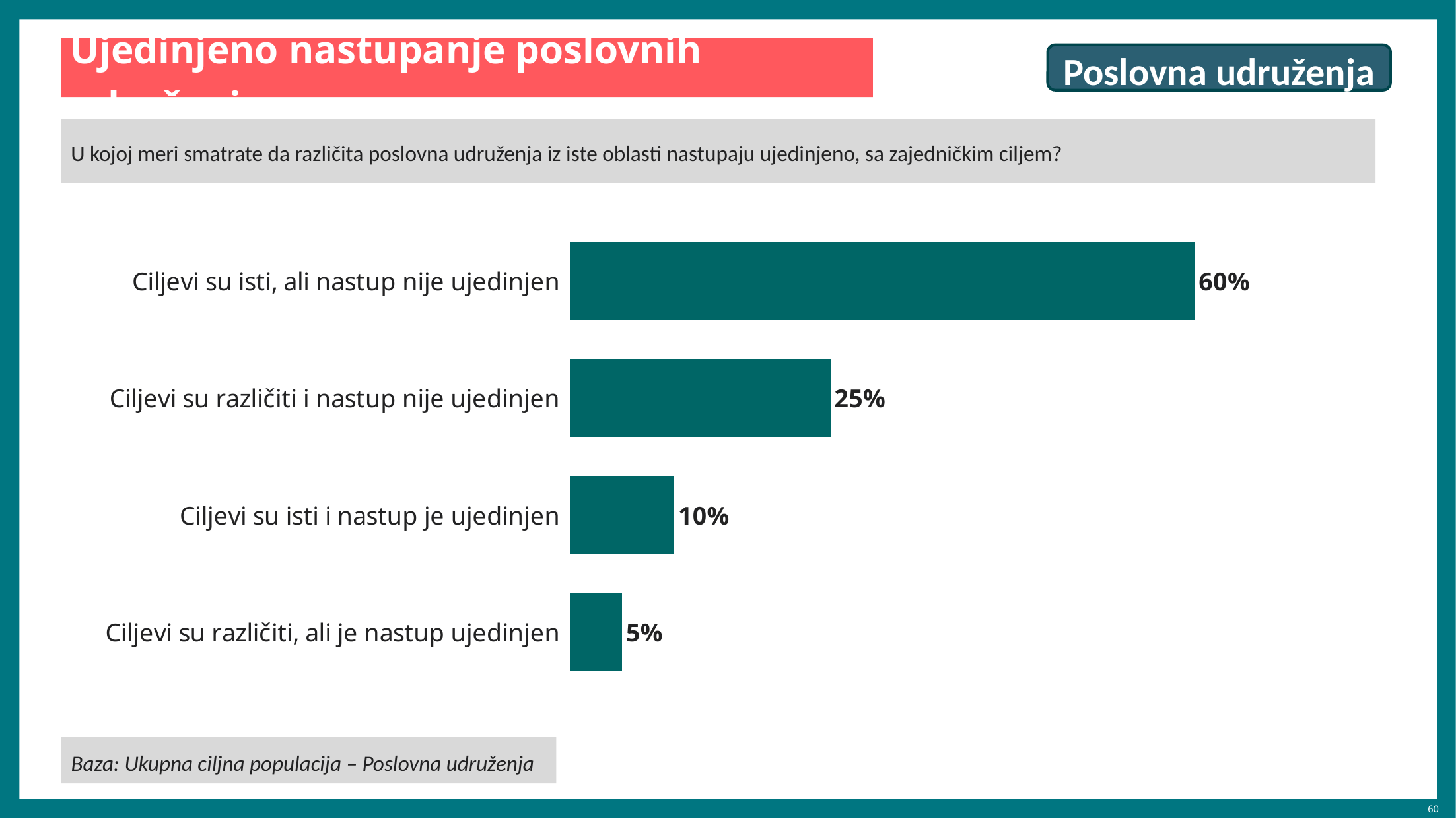
What is the value for "Ciljevi su isti i nastup je ujedinjen"? 10% Which is larger: the value for "Ciljevi su različiti i nastup nije ujedinjen" or "Ciljevi su isti i nastup je ujedinjen"? Ciljevi su različiti i nastup nije ujedinjen Which category has the lowest value? Ciljevi su različiti, ali je nastup ujedinjen What is the value for "Ciljevi su različiti, ali je nastup ujedinjen"? 5% How many categories are shown in the chart? 4 What is the difference between the values for "Ciljevi su isti, ali nastup nije ujedinjen" and "Ciljevi su različiti i nastup nije ujedinjen"? 35% What kind of chart is shown on the slide? Bar chart What is the difference between the values for "Ciljevi su isti i nastup je ujedinjen" and "Ciljevi su različiti, ali je nastup ujedinjen"? 5% What is the base (Baza) stated below the chart? Ukupna ciljna populacija – Poslovna udruženja Which category has the highest value? Ciljevi su isti, ali nastup nije ujedinjen What is the value for "Ciljevi su različiti i nastup nije ujedinjen"? 25% What is the value for "Ciljevi su isti, ali nastup nije ujedinjen"? 60%